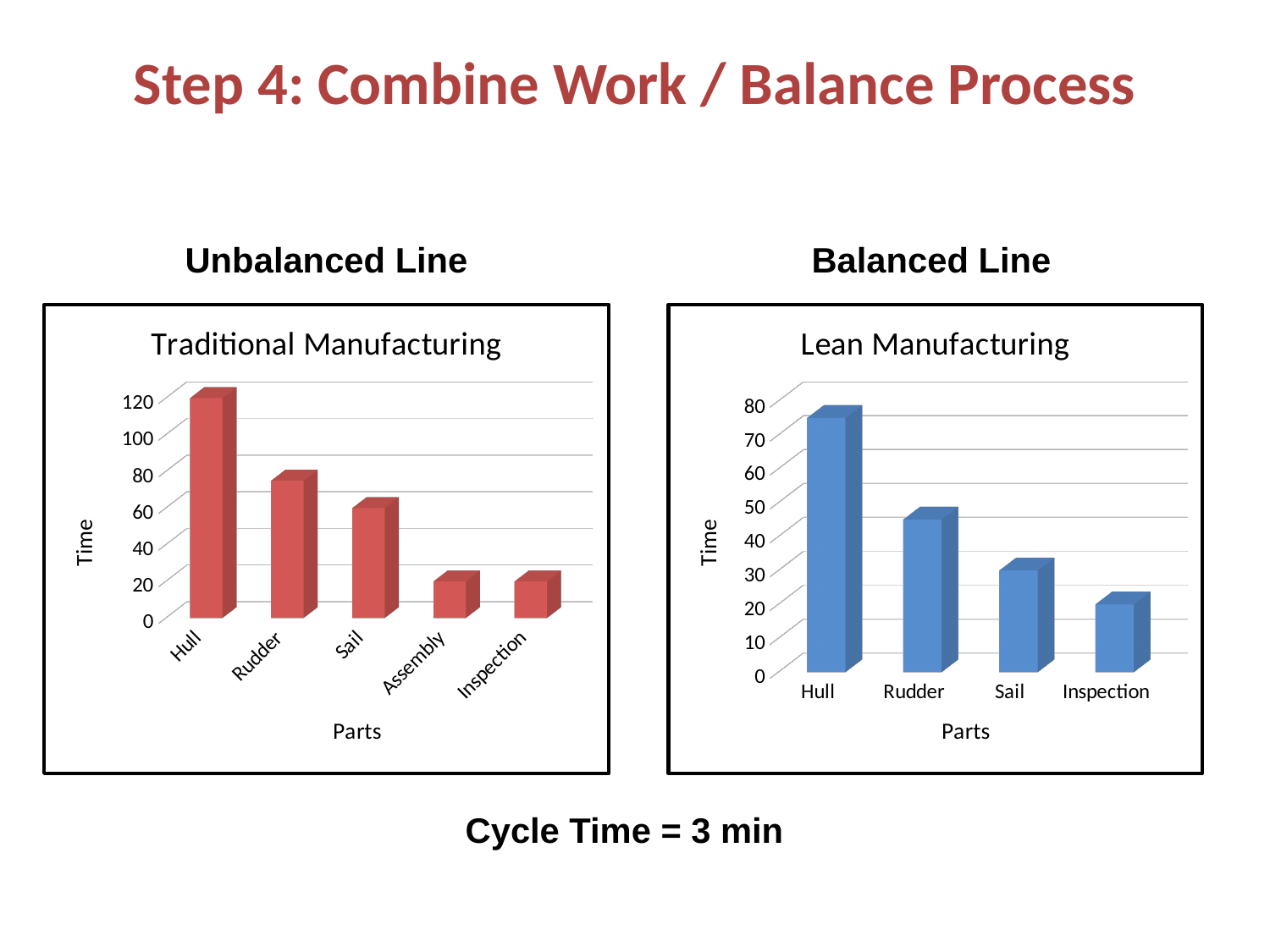
In the Lean Manufacturing chart, is the value for Rudder greater or less than 60? less In the Traditional Manufacturing chart, is the value for Hull greater or less than 100? greater What is the y-axis label on the Lean Manufacturing chart? Time How many parts are shown on the x axis of the Lean Manufacturing chart? 4 In the Lean Manufacturing chart, do the values rise or fall from Hull to Inspection? fall In the Lean Manufacturing chart, is the value for Sail greater or less than 20? greater In the Traditional Manufacturing chart, which is larger, the value for Rudder or the value for Sail? Rudder How many parts are shown on the x axis of the Traditional Manufacturing chart? 5 What type of chart is the Traditional Manufacturing chart? bar chart In the Lean Manufacturing chart, which part has the highest time? Hull In the Traditional Manufacturing chart, which part has the highest time? Hull In the Lean Manufacturing chart, which part has the lowest time? Inspection